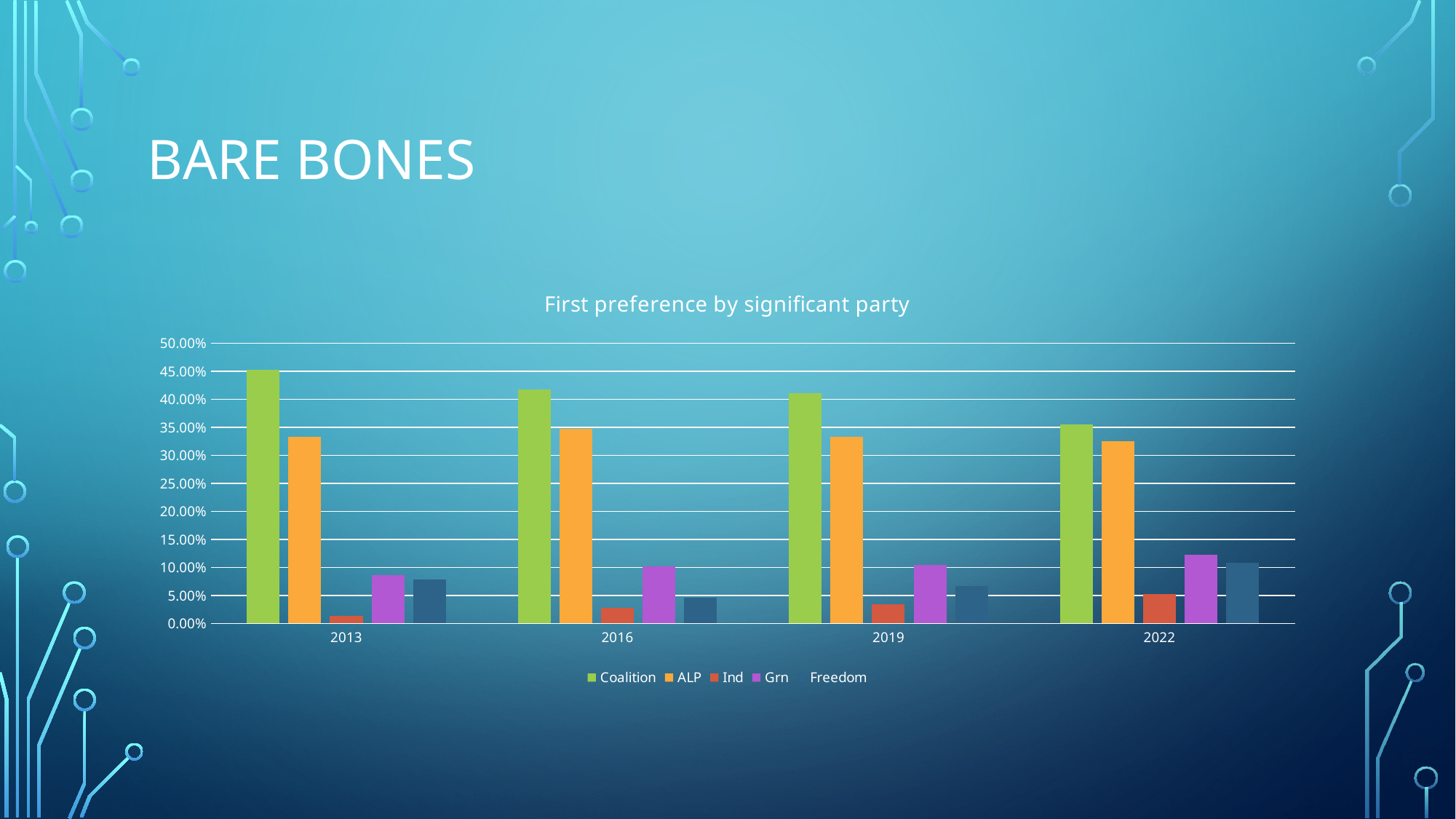
How many series does the legend list? 5 Which party has the lowest value in 2019? Ind Is the Grn value for 2022 greater or less than 10.00%? greater What kind of chart is shown on the slide? bar chart Is the Ind value for 2013 greater or less than 5.00%? less How many years are shown on the x axis of the chart? 4 What is the title of the chart? First preference by significant party Does the Coalition value rise or fall from 2013 to 2022? fall Is the Coalition value for 2013 greater or less than 40.00%? greater In 2016, which is larger: the Coalition value or the ALP value? Coalition In which year is the Coalition value highest? 2013